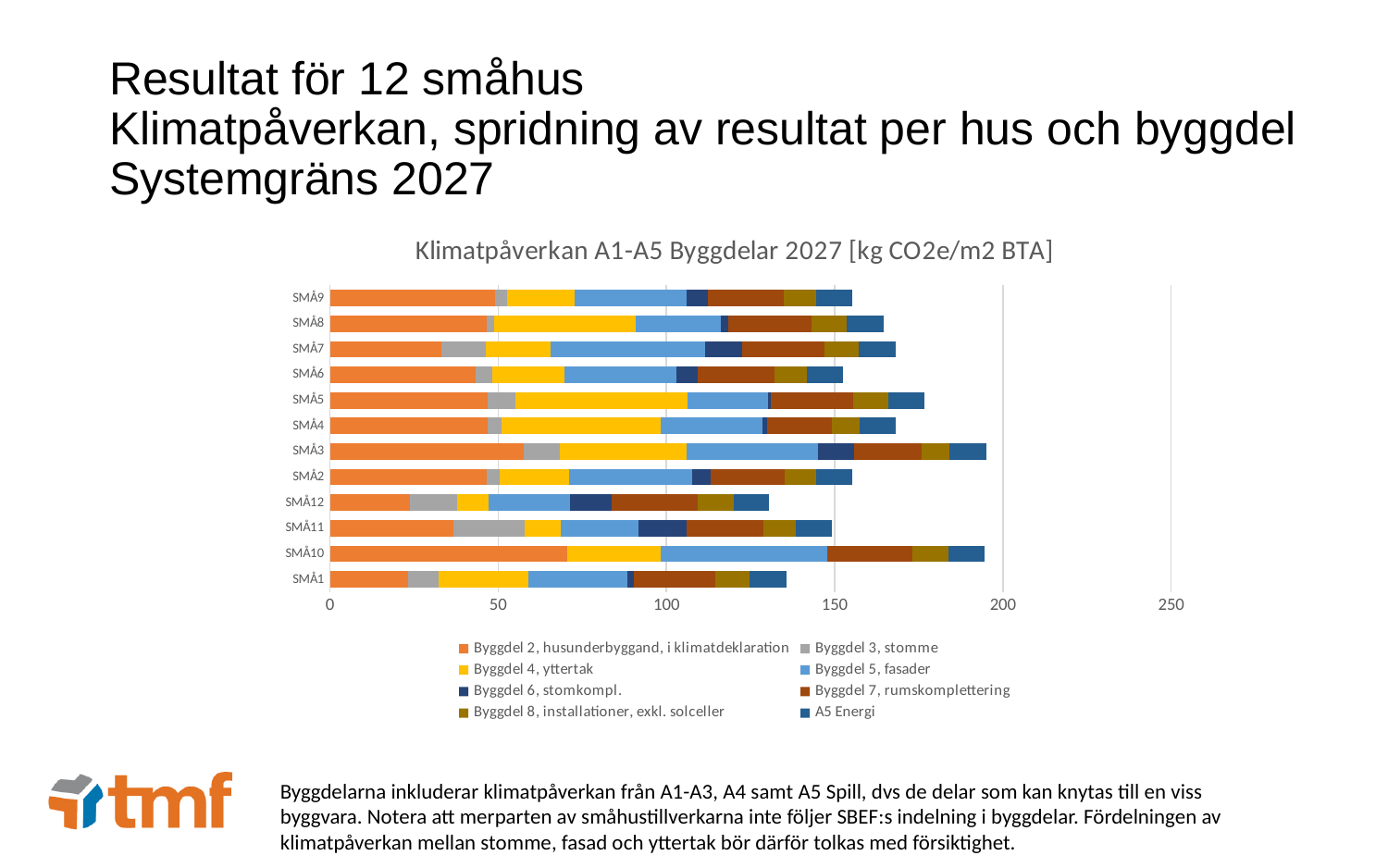
How many series does the chart legend list? 8 Which legend entry is shown in orange? Byggdel 2, husunderbyggand, i klimatdeklaration What kind of chart is shown on the slide? Stacked bar chart What is the title of the chart? Klimatpåverkan A1-A5 Byggdelar 2027 [kg CO2e/m2 BTA] Which has the larger total value, SMÅ3 or SMÅ12? SMÅ3 Is the total value for SMÅ1 greater or less than 150? less Is the total value for SMÅ10 greater or less than 150? greater Is the total value for SMÅ12 greater or less than 150? less Which has the larger total value, SMÅ5 or SMÅ1? SMÅ5 How many houses (categories) are plotted in the chart? 12